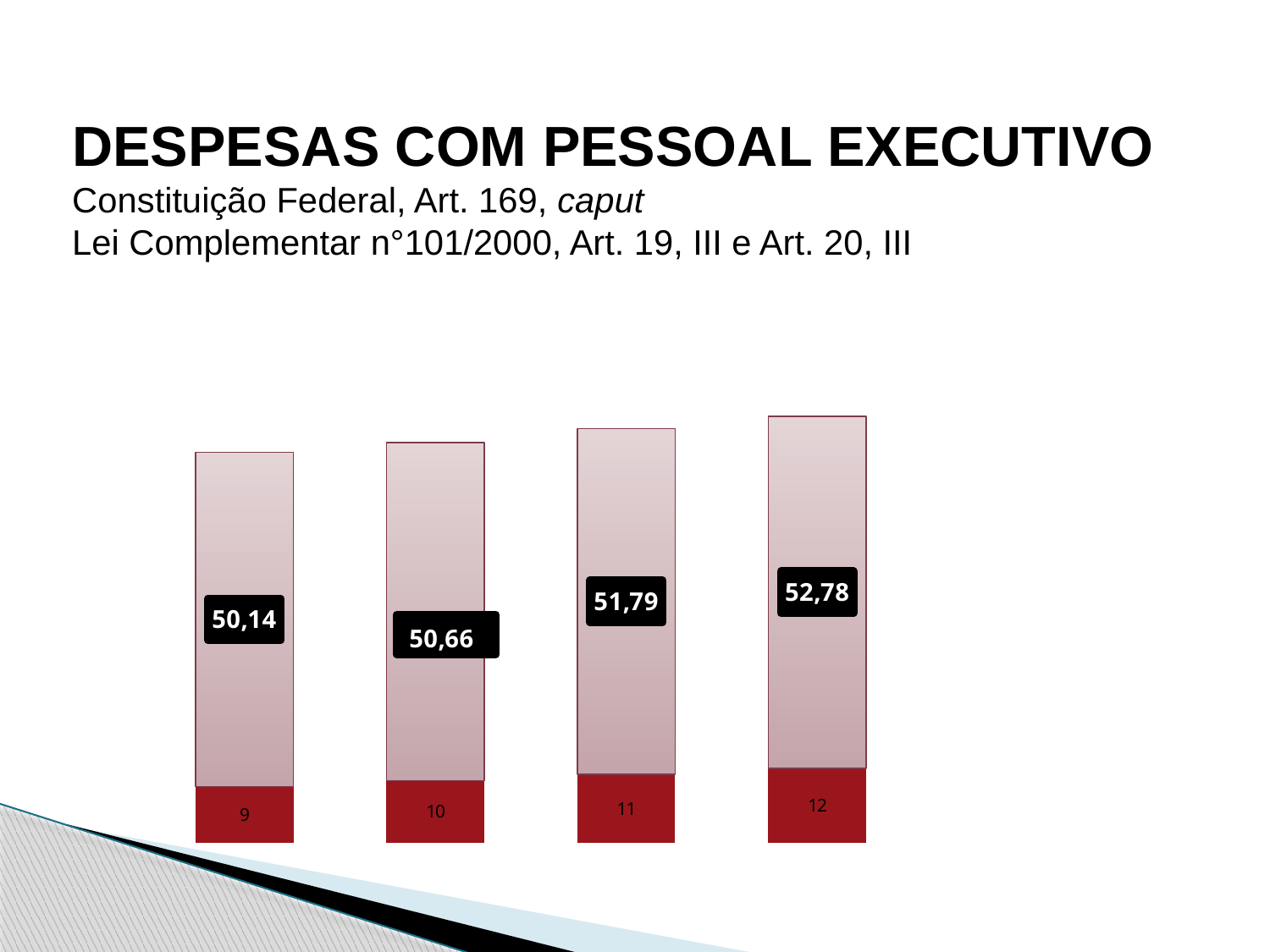
What is the value shown for category 10? 50,66 Which category has the lowest value? 9 Which is larger, the value for category 10 or the value for category 11? 11 What kind of chart is shown on the slide? bar chart What is the value shown for category 9? 50,14 Do the values rise or fall from category 9 to category 12? rise Which category has the highest value? 12 What is the value shown for category 11? 51,79 What is the difference between the values for category 12 and category 9? 2,64 How many bars are plotted in the chart? 4 What is the difference between the values for category 11 and category 10? 1,13 What is the value shown for category 12? 52,78